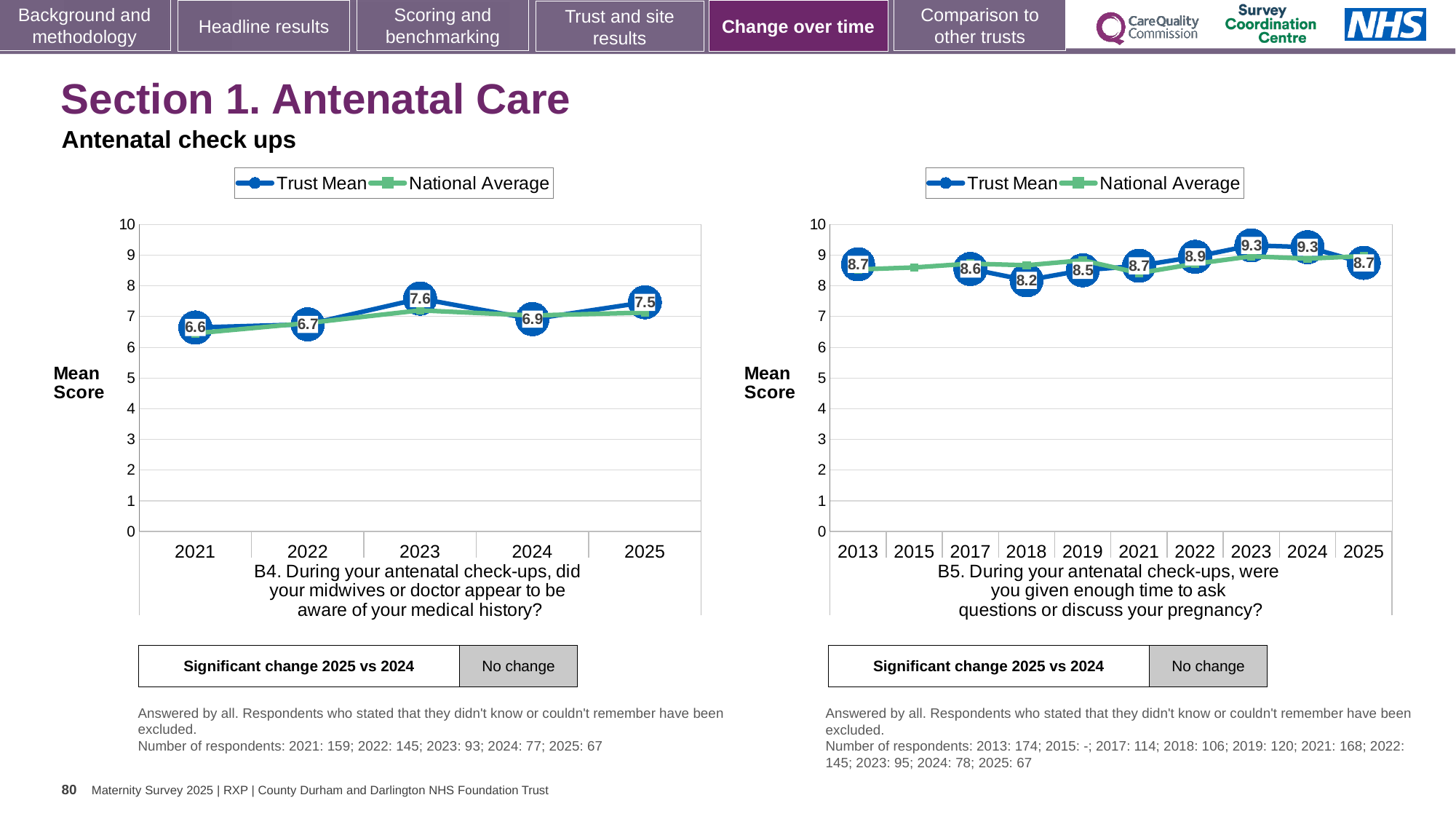
In the B5 chart on the right, what is the Trust Mean for 2025? 8.7 What kind of chart is the B4 chart on the left? line chart In the B4 chart on the left, which year has the lowest Trust Mean? 2021 In the B4 chart on the left, which year has the highest Trust Mean? 2023 In the B4 chart on the left, what is the Trust Mean for 2021? 6.6 In the B5 chart on the right, how many years are shown on the x axis? 10 In the B5 chart on the right, what is the Trust Mean for 2018? 8.2 In the B5 chart on the right, which year has the lowest Trust Mean? 2018 In the B4 chart on the left, how many series does the legend list? 2 In the B4 chart on the left, what is the difference between the Trust Mean for 2025 and 2024? 0.6 In the B4 chart on the left, what is the Trust Mean for 2023? 7.6 In the B5 chart on the right, is the Trust Mean for 2022 larger or smaller than for 2019? larger